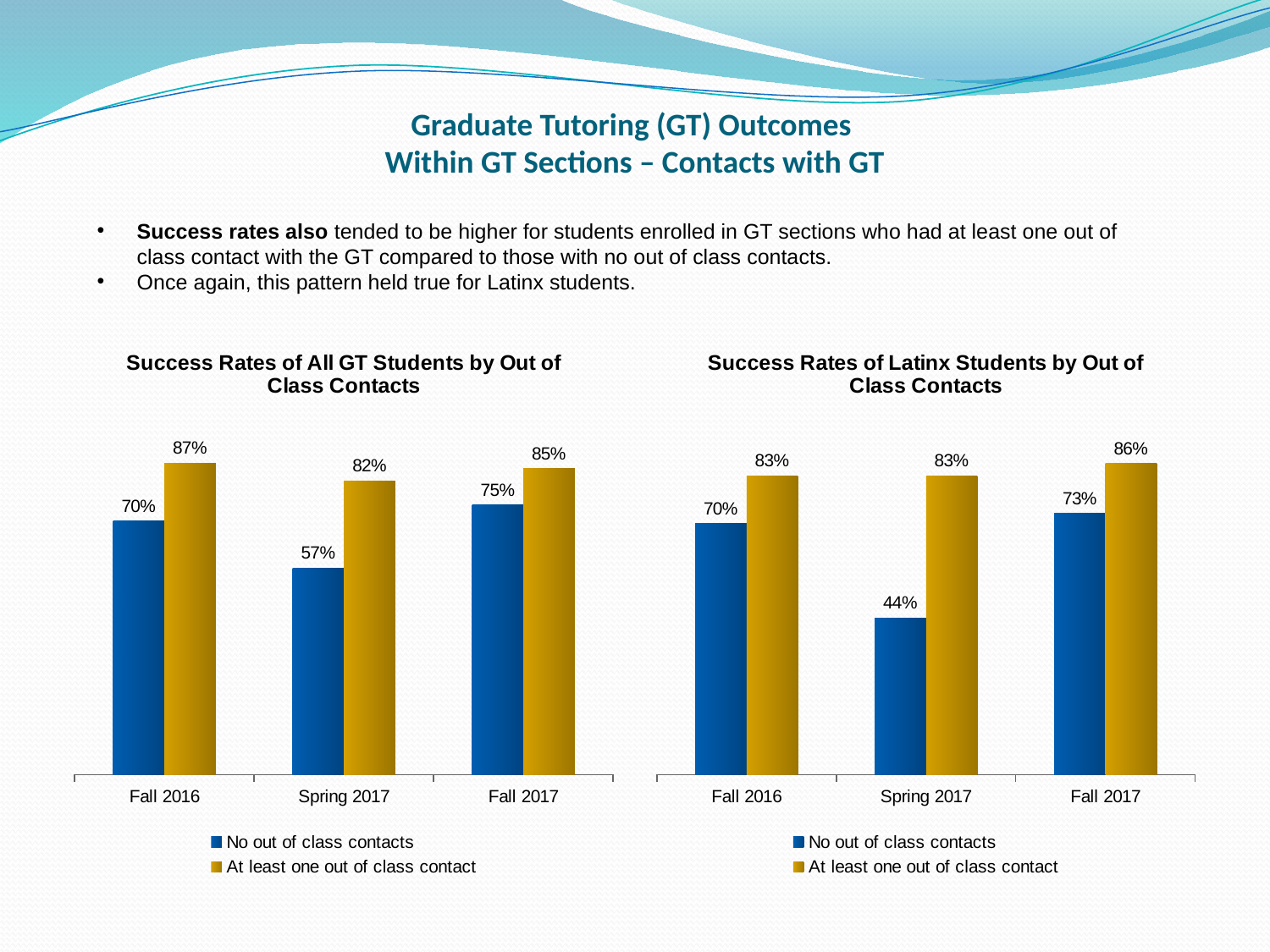
In the 'Success Rates of All GT Students by Out of Class Contacts' chart, what is the success rate for students with at least one out of class contact in Fall 2016? 87% In the 'Success Rates of Latinx Students by Out of Class Contacts' chart, what is the difference between the two series in Spring 2017? 39% In the 'Success Rates of All GT Students by Out of Class Contacts' chart, which is larger: the Fall 2016 value for no out of class contacts or the Fall 2017 value for no out of class contacts? Fall 2017 What type of chart is the 'Success Rates of Latinx Students by Out of Class Contacts' chart? Bar chart In the 'Success Rates of All GT Students by Out of Class Contacts' chart, which term has the lowest success rate for students with no out of class contacts? Spring 2017 How many series does the legend of the 'Success Rates of All GT Students by Out of Class Contacts' chart list? 2 How many terms are shown on the x axis of the 'Success Rates of Latinx Students by Out of Class Contacts' chart? 3 In the 'Success Rates of Latinx Students by Out of Class Contacts' chart, which term has the highest success rate for students with at least one out of class contact? Fall 2017 In the 'Success Rates of All GT Students by Out of Class Contacts' chart, what is the difference between the two series in Fall 2017? 10% In the 'Success Rates of All GT Students by Out of Class Contacts' chart, what is the success rate for students with no out of class contacts in Spring 2017? 57% In the 'Success Rates of Latinx Students by Out of Class Contacts' chart, what is the success rate for students with no out of class contacts in Spring 2017? 44% In the 'Success Rates of Latinx Students by Out of Class Contacts' chart, what is the success rate for students with at least one out of class contact in Fall 2017? 86%